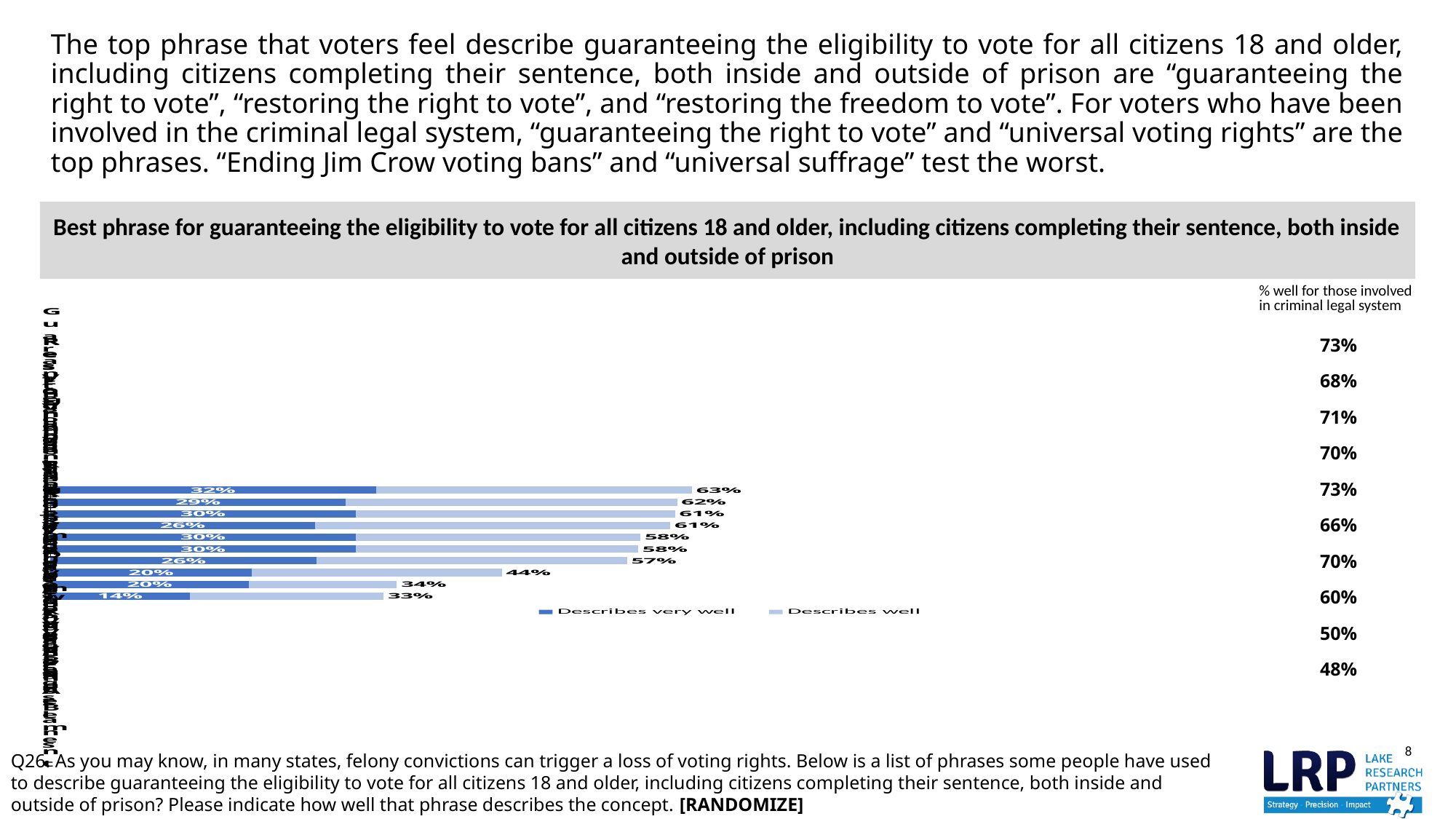
For the bottom bar in the chart, what is the 'Describes well' value? 33% What are the two series named in the chart legend? Describes very well; Describes well In the '% well for those involved in criminal legal system' column, what is the lowest value shown? 48% What is the highest 'Describes very well' value labelled in the chart? 32% For the top bar in the chart, what is the 'Describes very well' value? 32% What is the highest 'Describes well' value labelled in the chart? 63% How many phrases (bars) are plotted in the chart? 10 What is the difference between the highest and lowest 'Describes well' values in the chart? 30 percentage points What kind of chart is shown on the slide? bar chart What is the lowest 'Describes well' value labelled in the chart? 33% How many series does the chart legend list? 2 What is the lowest 'Describes very well' value labelled in the chart? 14%